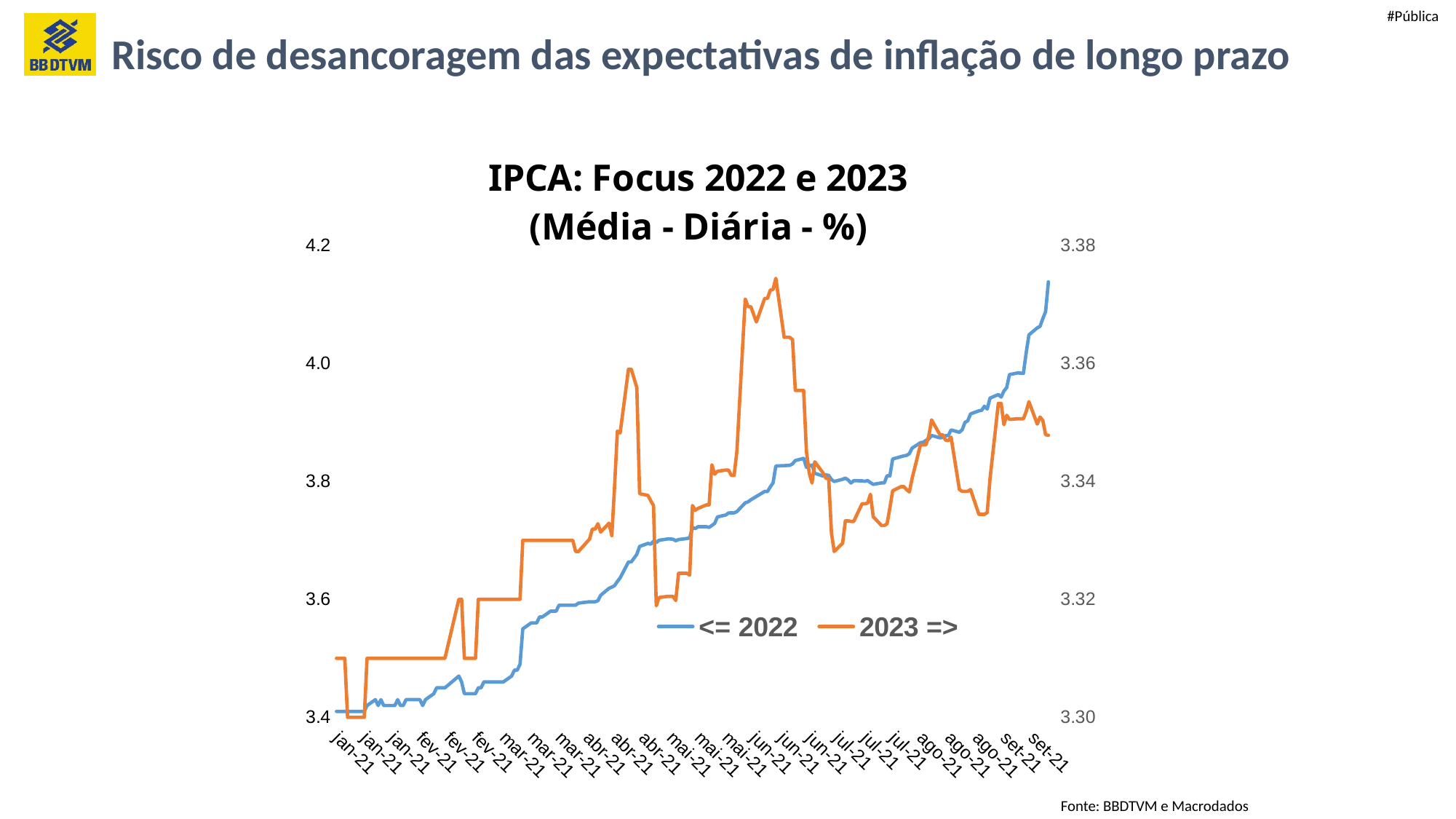
Is the value for <= 2022 in jan-21 greater or less than 3.6? less What are the two legend entries of the chart? <= 2022 and 2023 => What kind of chart is shown on the slide? line chart In which month does the <= 2022 series reach its highest value? set-21 Does the <= 2022 series rise or fall overall from jan-21 to set-21? rise Is the <= 2022 series higher in set-21 or in jan-21? set-21 Is the peak value for 2023 => in jun-21 greater or less than 3.36 on the right axis? greater What is the title of the chart? IPCA: Focus 2022 e 2023 (Média - Diária - %) Is the value for <= 2022 at the end of set-21 greater or less than 4.0? greater How many series does the legend list? 2